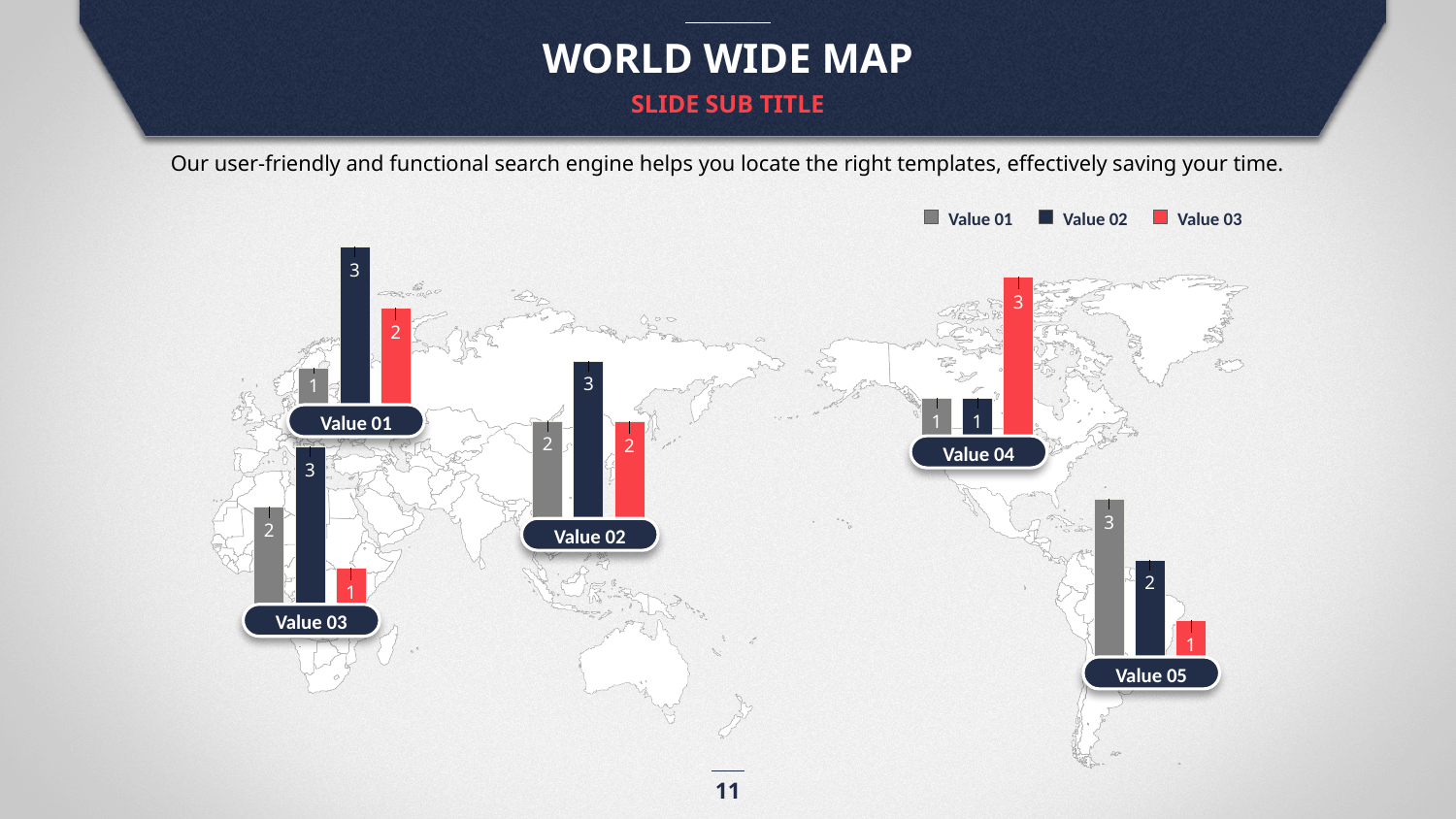
Which colour represents the Value 03 series in the legend? red In the bar group labelled Value 05, what is the value of the gray (Value 01) bar? 3 In the bar group labelled Value 01, what is the total of the three bars? 6 How many series does the legend at the top right list? 3 What kind of chart is used for the data groups plotted on the world map? bar chart In the bar group labelled Value 02, what is the difference between the dark navy (Value 02) bar and the gray (Value 01) bar? 1 How many labelled bar groups are placed on the map? 5 In the bar group labelled Value 05, which series has the lowest bar? Value 03 In the bar group labelled Value 03, what is the value of the red (Value 03) bar? 1 In the bar group labelled Value 04, what is the value of the red (Value 03) bar? 3 In the bar group labelled Value 01, which series has the highest bar? Value 02 In the bar group labelled Value 04, which is larger: the gray (Value 01) bar or the red (Value 03) bar? Value 03